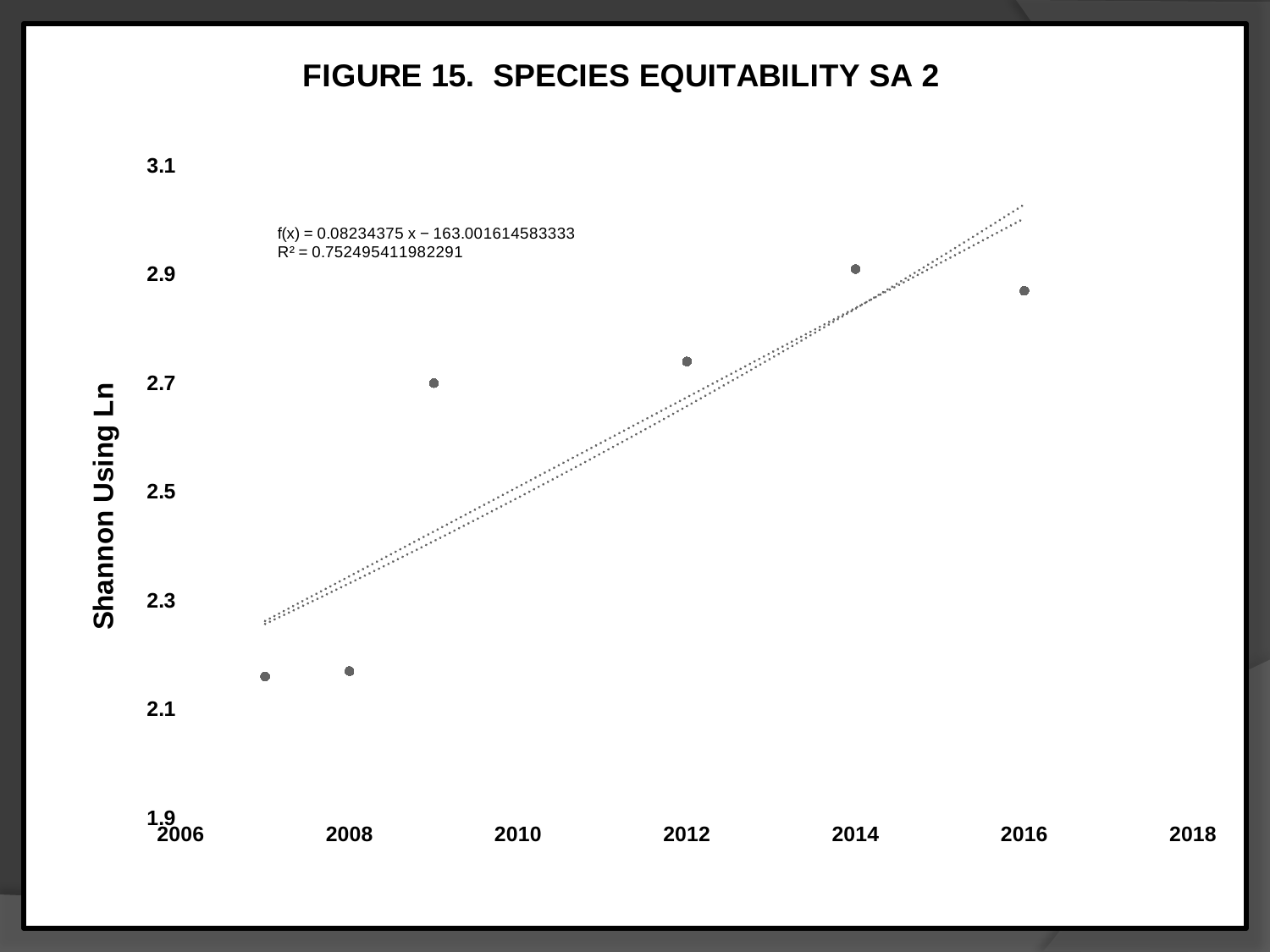
Do the plotted values generally rise or fall from 2007 to 2016? rise Is the value for 2012 greater or less than 2.7? greater Which year has the highest plotted value? 2014 Which is larger, the value for 2009 or the value for 2008? 2009 Is the value for 2007 greater or less than 2.3? less What R² value is printed for the trendline? 0.752495411982291 How many data points are plotted on the chart? 6 Is the value for 2016 greater or less than 2.9? less What is the label of the y axis? Shannon Using Ln What is the title of the chart? FIGURE 15. SPECIES EQUITABILITY SA 2 What kind of chart is shown on the slide? scatter plot